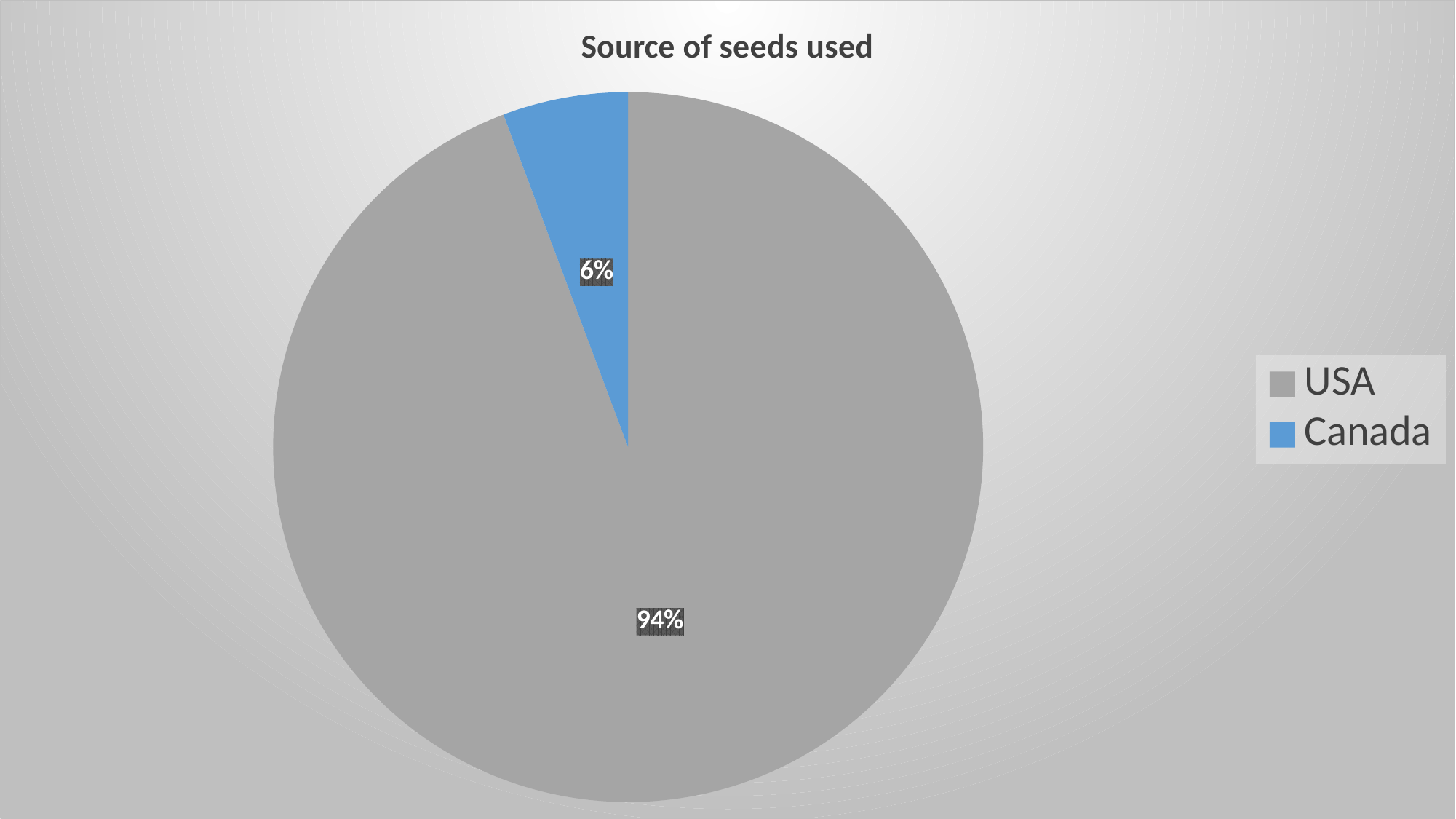
What colour is the Canada slice? blue What is the total of the two slices shown? 100% How many categories are shown in the pie chart? 2 What is the title of the chart? Source of seeds used What is the difference in percentage points between the USA and Canada slices? 88 What share of the pie does Canada account for? 6% What kind of chart is shown on the slide? pie chart How many entries does the legend list? 2 Which slice is larger, USA or Canada? USA Which category has the smallest slice of the pie? Canada Which category has the largest slice of the pie? USA What share of the pie does USA account for? 94%